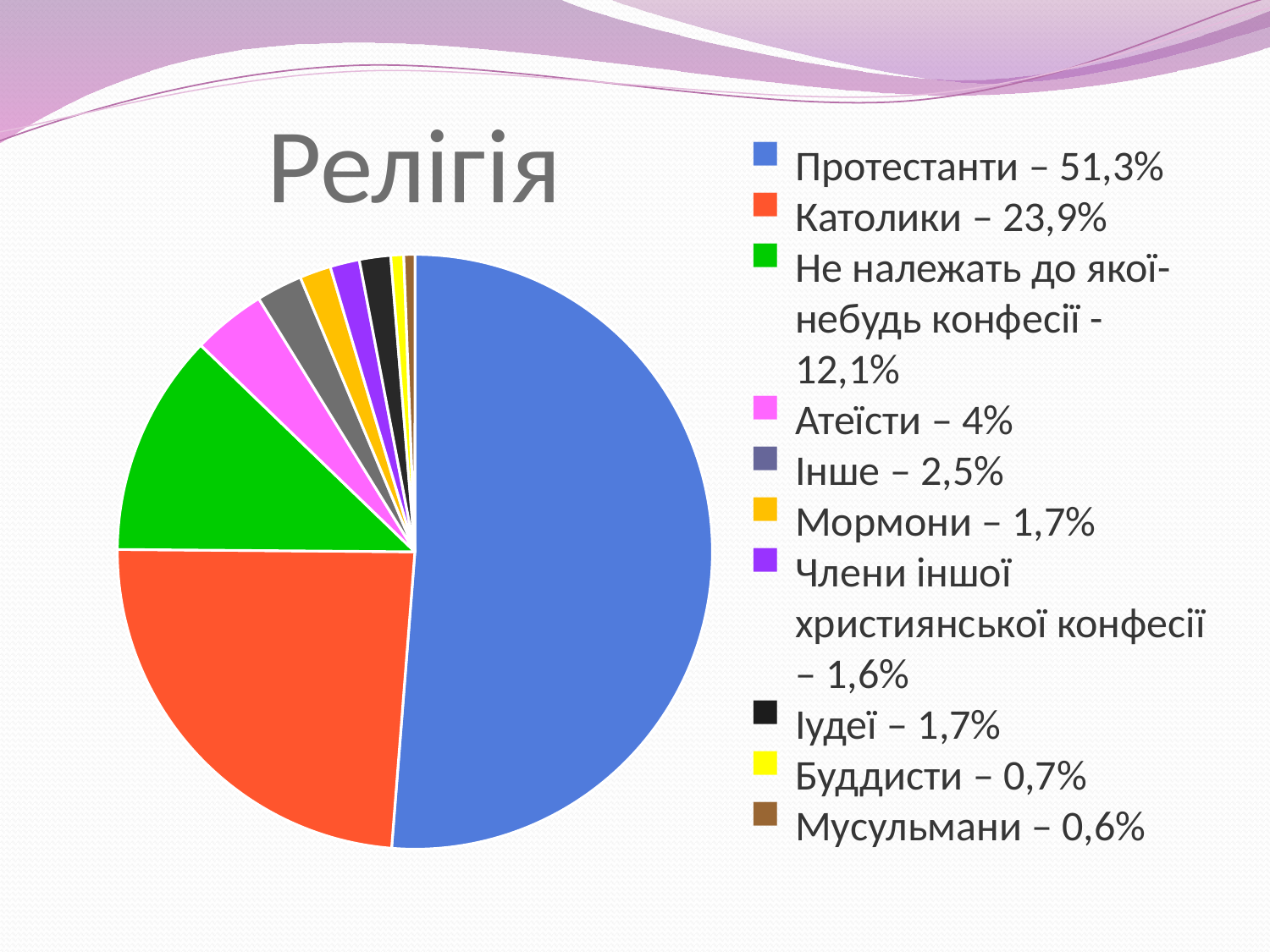
What is the value for Не належать до якої-небудь конфесії? 12,1% What is the value for Католики? 23,9% What share of the pie is Протестанти? 51,3% What is the value for Атеїсти? 4% What colour is the slice for Буддисти? yellow Which category has the smallest share of the pie? Мусульмани What is the difference between the shares of Протестанти and Католики? 27,4% What is the title of the chart? Релігія How many categories does the pie chart have? 10 What kind of chart is shown on the slide? pie chart Which is larger, the share for Католики or the share for Не належать до якої-небудь конфесії? Католики Which category has the largest share of the pie? Протестанти